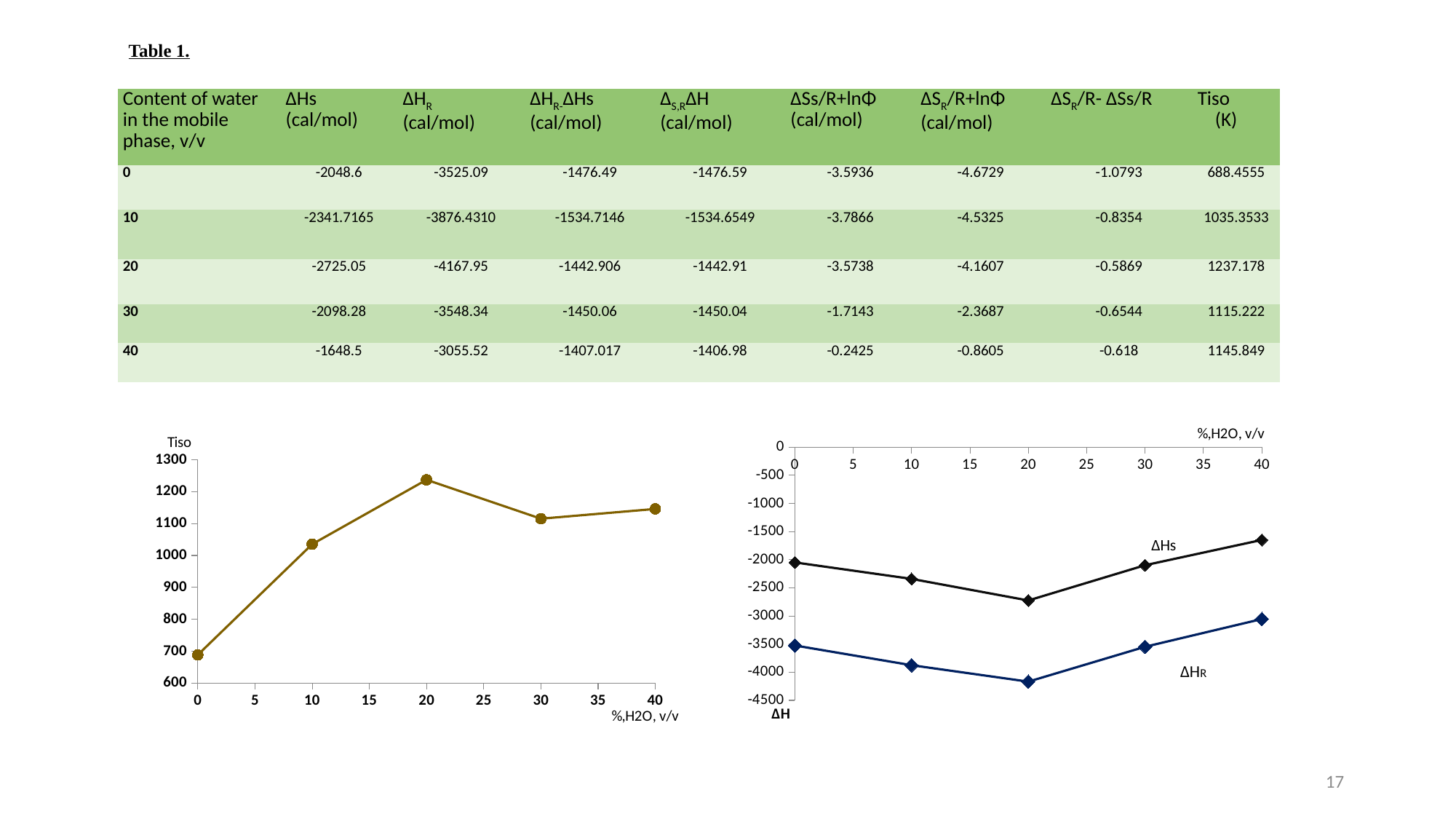
In the right chart (ΔH), how many series are plotted? 2 In the right chart (ΔH), at 40 %H2O, which is larger: ΔHs or ΔHR? ΔHs In the right chart (ΔH), is the ΔHR value at 20 %H2O greater or less than -4000? less In the right chart (ΔH), at which %H2O value is ΔHs lowest? 20 In the left chart (Tiso), is the value at 10 %H2O greater or less than 1000? greater In the left chart (Tiso), at which %H2O value is Tiso lowest? 0 In the left chart (Tiso), how many data points are plotted? 5 What is the x-axis label of the left chart (Tiso)? %,H2O, v/v What kind of chart is the left chart (Tiso)? line chart In the left chart (Tiso), do the values rise or fall from 0 to 20 %H2O? rise In the left chart (Tiso), at which %H2O value is Tiso highest? 20